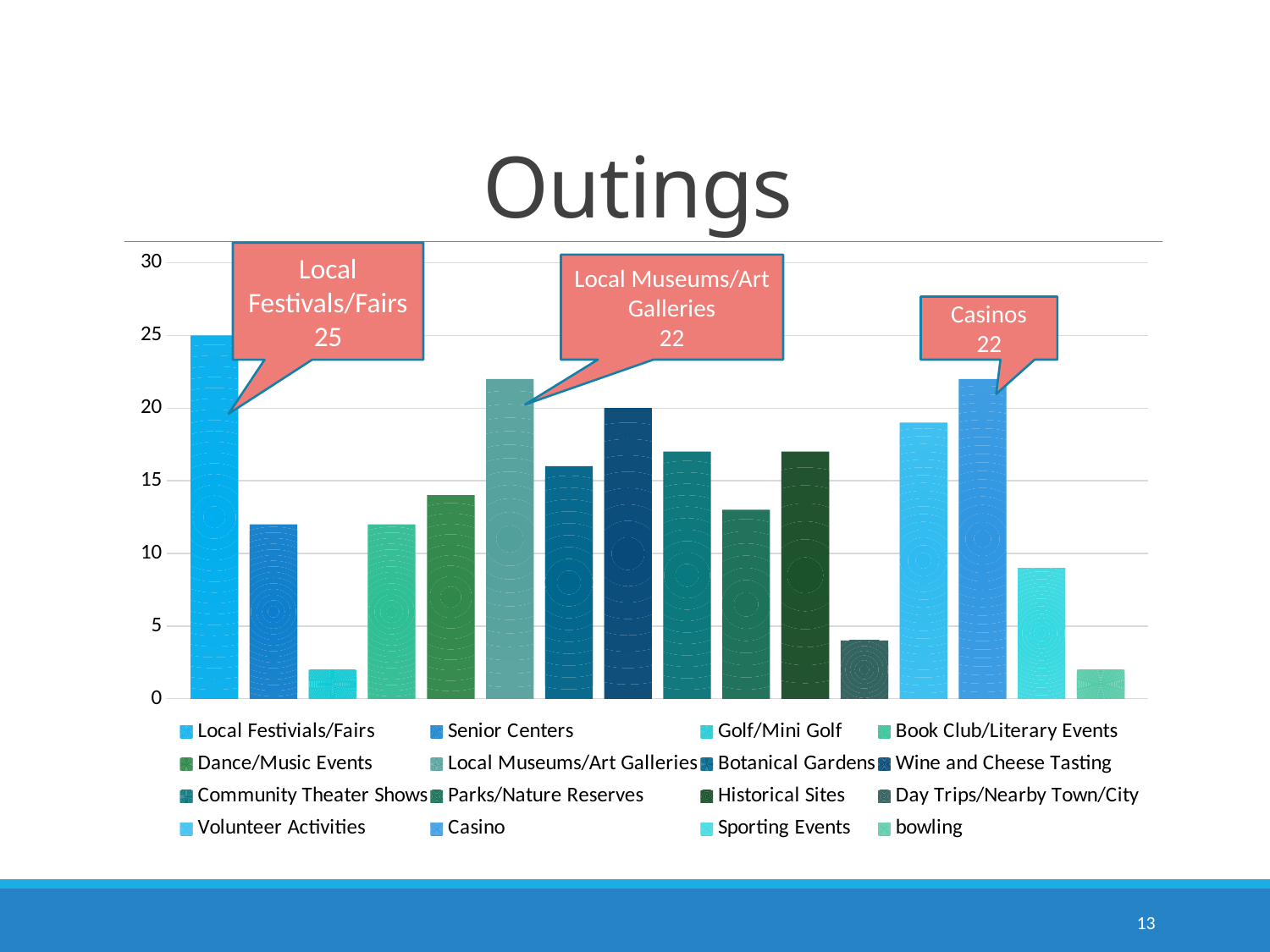
What is the value for Local Festivials/Fairs? 25 What kind of chart is shown on the slide? Bar chart Which is larger, the value for Local Festivials/Fairs or the value for Casino? Local Festivials/Fairs What is the value for Local Museums/Art Galleries? 22 What is the title of the slide? Outings Is the value for Day Trips/Nearby Town/City greater or less than 5? less What is the value for Casino? 22 Is the value for Volunteer Activities greater or less than 15? greater What is the difference between the values for Local Festivials/Fairs and Local Museums/Art Galleries? 3 How many series does the legend list? 16 Is the value for Senior Centers greater or less than 10? greater Which category has the highest value? Local Festivials/Fairs